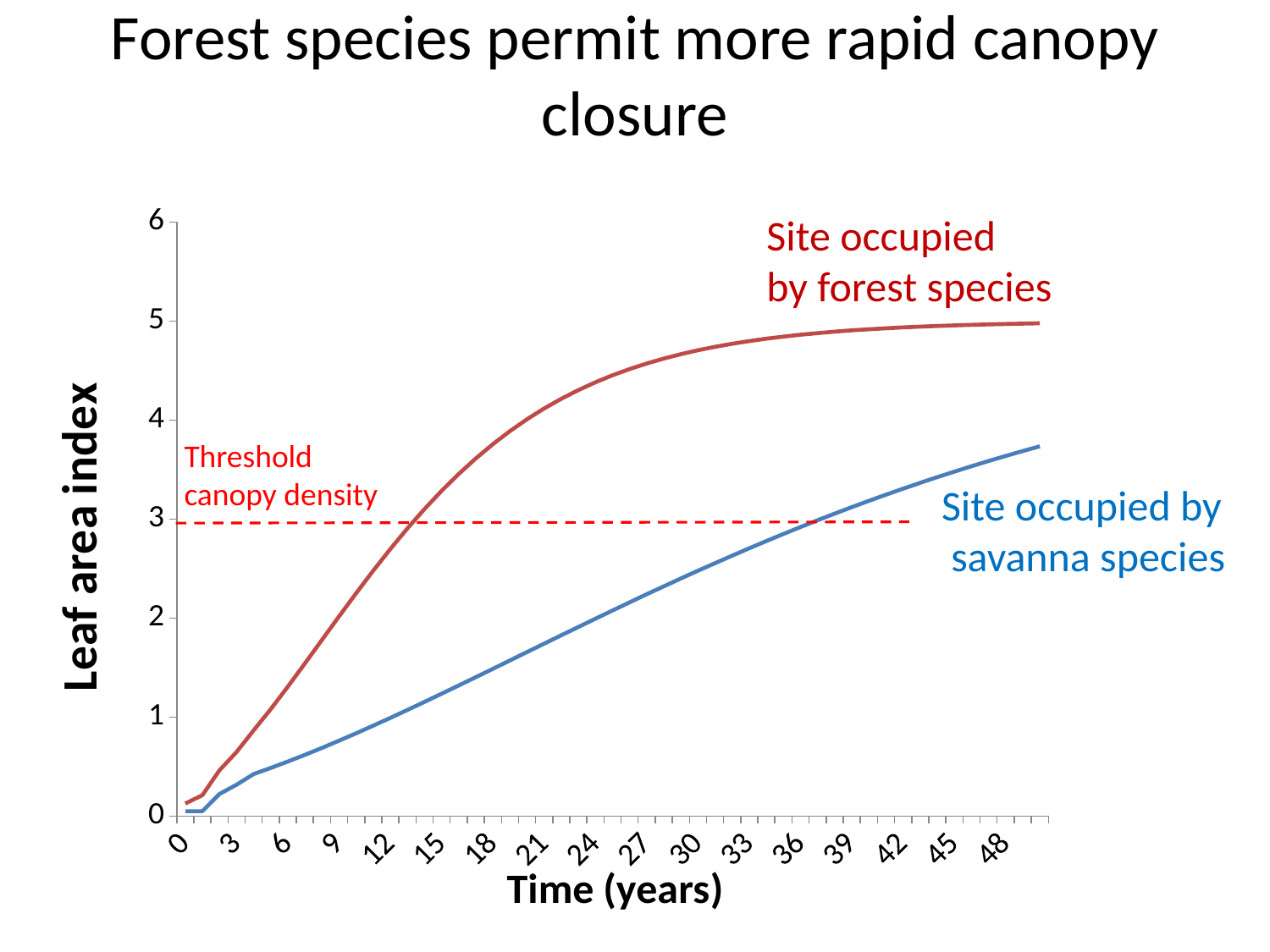
What kind of chart is shown on the slide? line chart Does the leaf area index for the site occupied by savanna species rise or fall over time? rise What is the title of the chart on the slide? Forest species permit more rapid canopy closure Which site reaches the threshold canopy density first, the one occupied by forest species or the one occupied by savanna species? Site occupied by forest species Does the leaf area index for the site occupied by forest species rise or fall over time? rise Is the leaf area index for the site occupied by forest species at 12 years greater or less than 2? greater Is the leaf area index for the site occupied by savanna species at 30 years greater or less than 3? less Is the leaf area index for the site occupied by savanna species at 48 years greater or less than 4? less What is the label of the y axis? Leaf area index How many species sites are plotted as solid lines on the chart? 2 At 24 years, which site has the higher leaf area index, the one occupied by forest species or the one occupied by savanna species? Site occupied by forest species